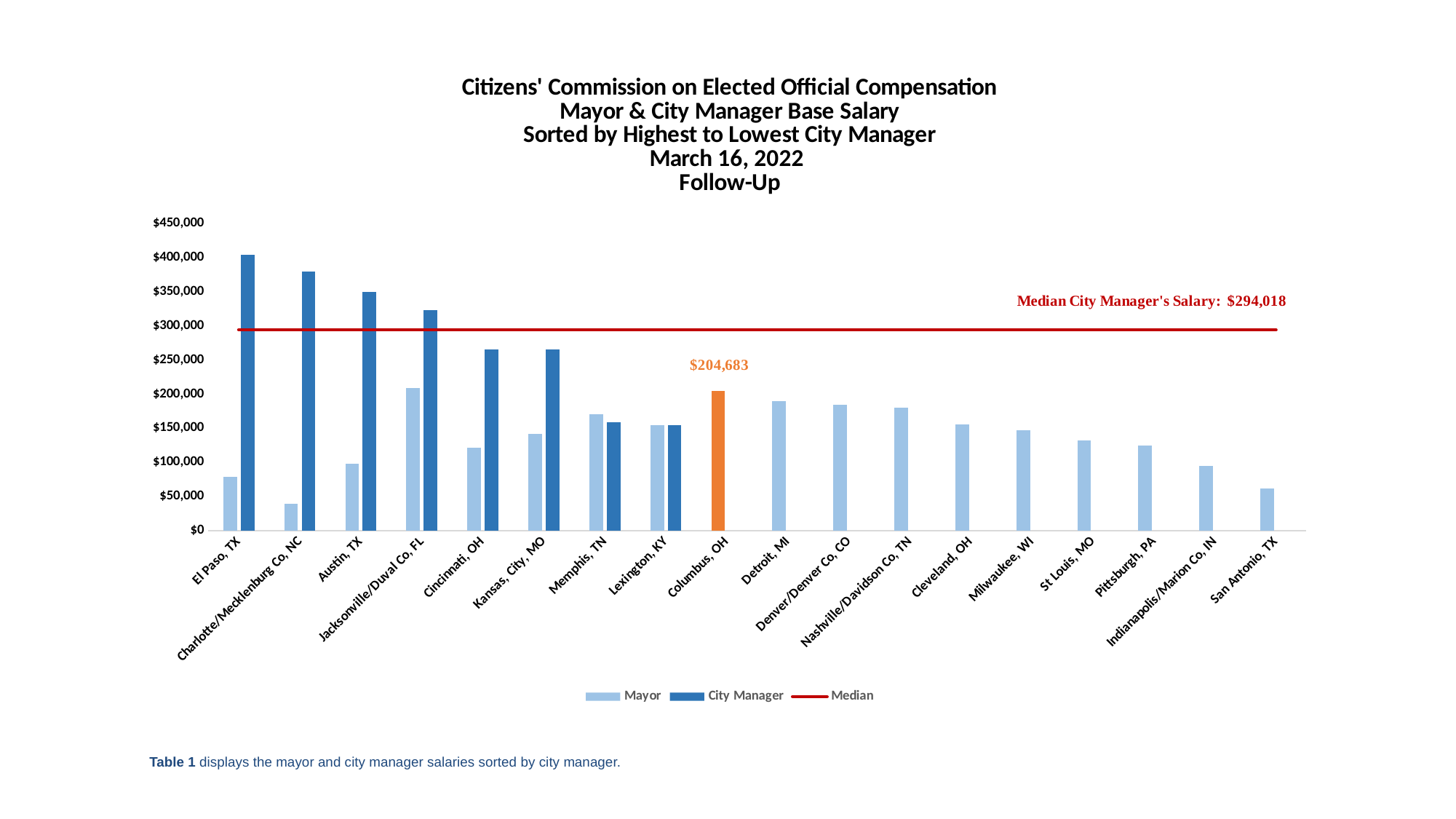
Which city has the lowest Mayor salary? Charlotte/Mecklenburg Co, NC Is the City Manager salary for Cincinnati, OH greater or less than $300,000? less How many series does the legend list? 3 How many cities are shown on the x axis? 18 Is the City Manager salary for Charlotte/Mecklenburg Co, NC greater or less than $350,000? greater What is the Mayor salary value labelled for Columbus, OH? $204,683 What kind of chart is shown on the slide? Bar chart Which city has the highest City Manager salary? El Paso, TX Do the City Manager salaries rise or fall from left to right along the x axis? Fall What is the Median City Manager's Salary shown on the chart? $294,018 For Cincinnati, OH, which is larger: the Mayor salary or the City Manager salary? City Manager